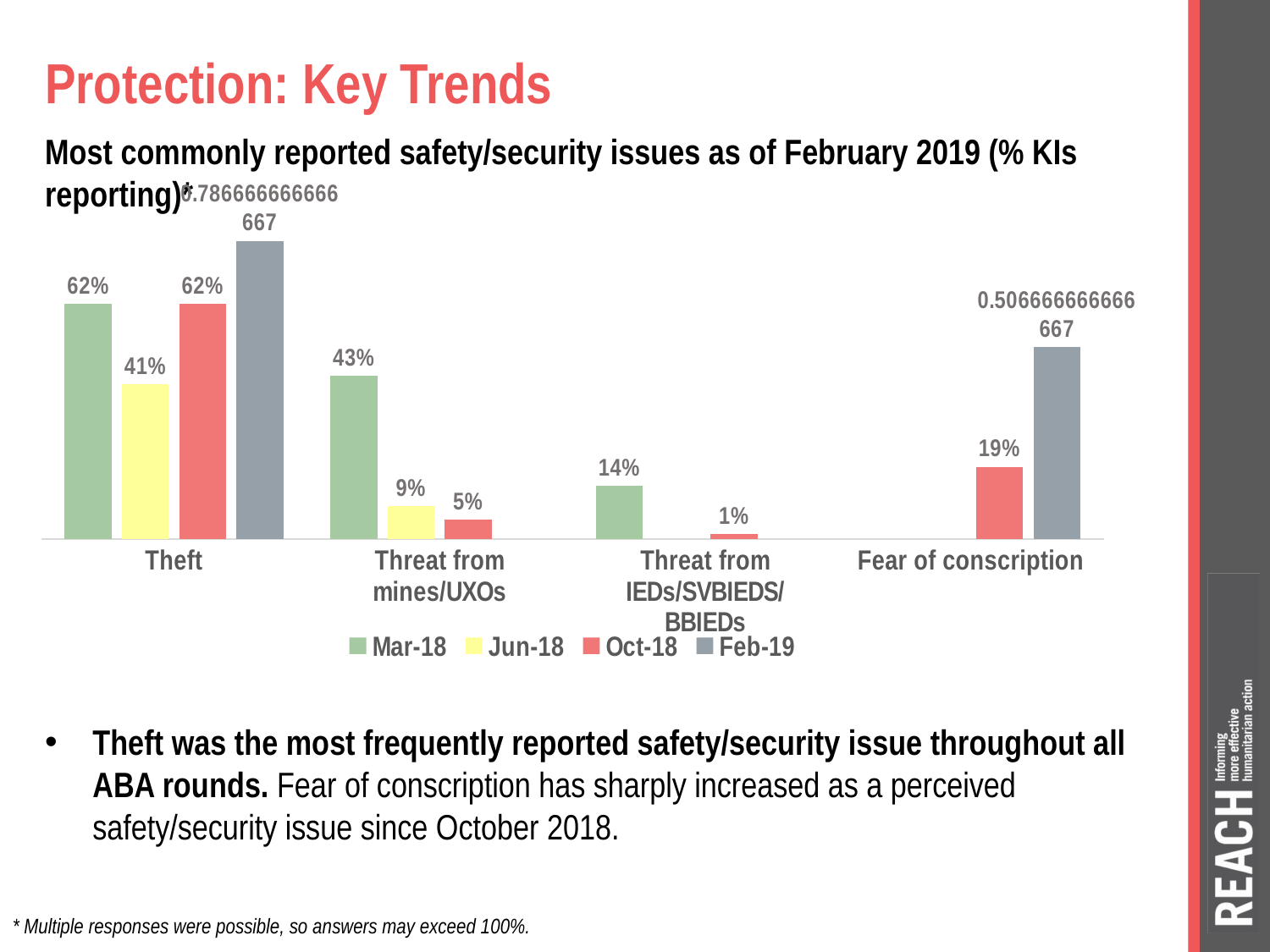
What is the Mar-18 value for Theft? 62% How many categories are shown on the x axis? 4 What is the Mar-18 value for Threat from mines/UXOs? 43% What is the Jun-18 value for Theft? 41% Which category has the highest Mar-18 value? Theft How many series does the legend list? 4 Which series is shown in yellow in the legend? Jun-18 What type of chart is shown on the slide? bar chart Which is larger: the Feb-19 value for Theft or the Feb-19 value for Fear of conscription? Theft What is the difference between the Jun-18 and Oct-18 values for Threat from mines/UXOs? 4% What is the Oct-18 value for Threat from IEDs/SVBIEDS/BBIEDs? 1% What is the Oct-18 value for Fear of conscription? 19%